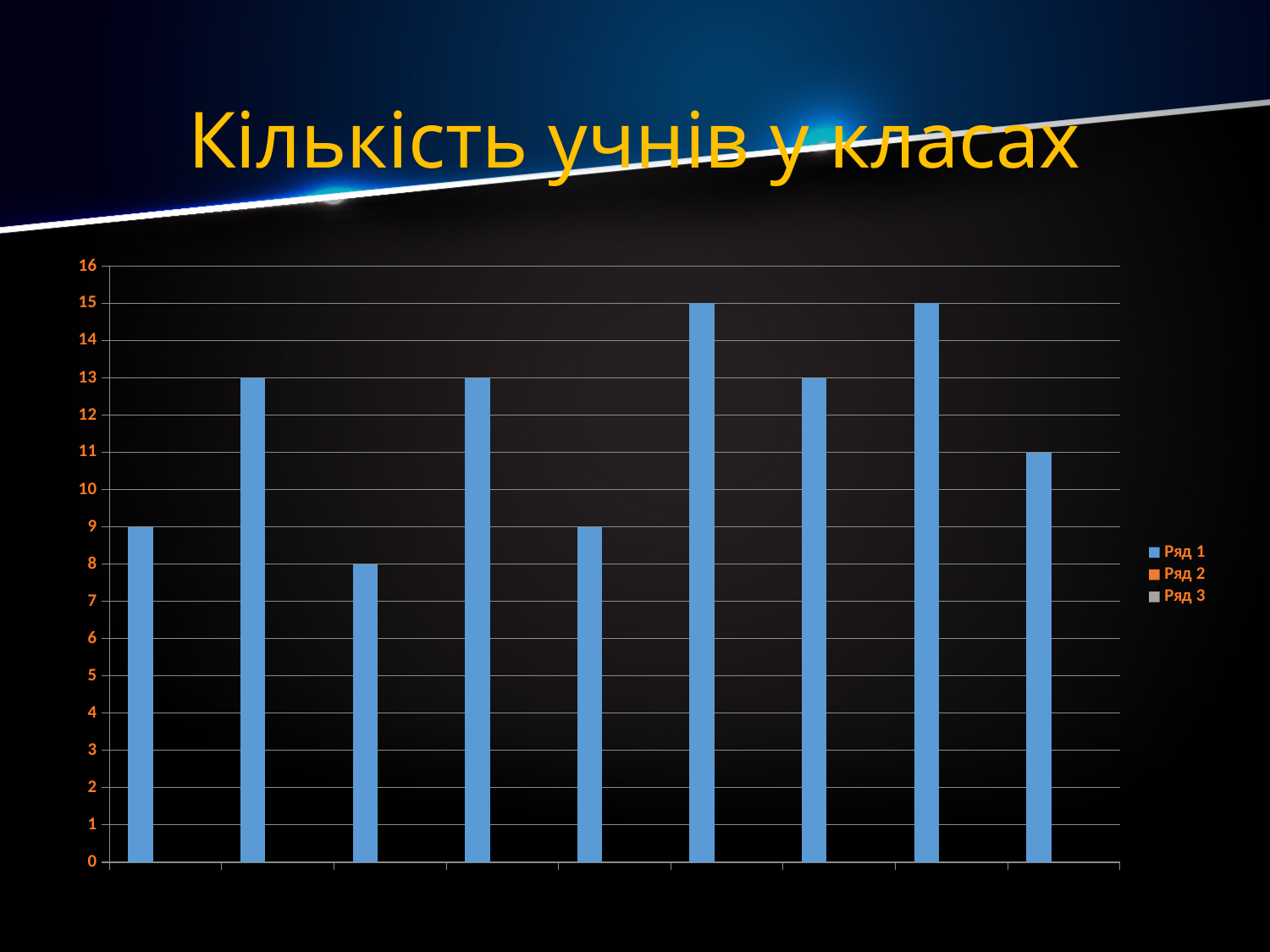
What is the title of the chart on the slide? Кількість учнів у класах How many series does the legend list? 3 Is the value of the ninth bar greater or less than 10? greater Which is larger, the second bar or the fifth bar? The second bar What is the value of the third bar from the left? 8 What is the lowest value reached by any bar in the chart? 8 What is the difference between the sixth bar and the third bar? 7 What is the value of the last (rightmost) bar? 11 What is the highest value reached by any bar in the chart? 15 What kind of chart is shown on the slide? Bar chart How many bars are plotted in the chart? 9 What is the value of the first (leftmost) bar? 9